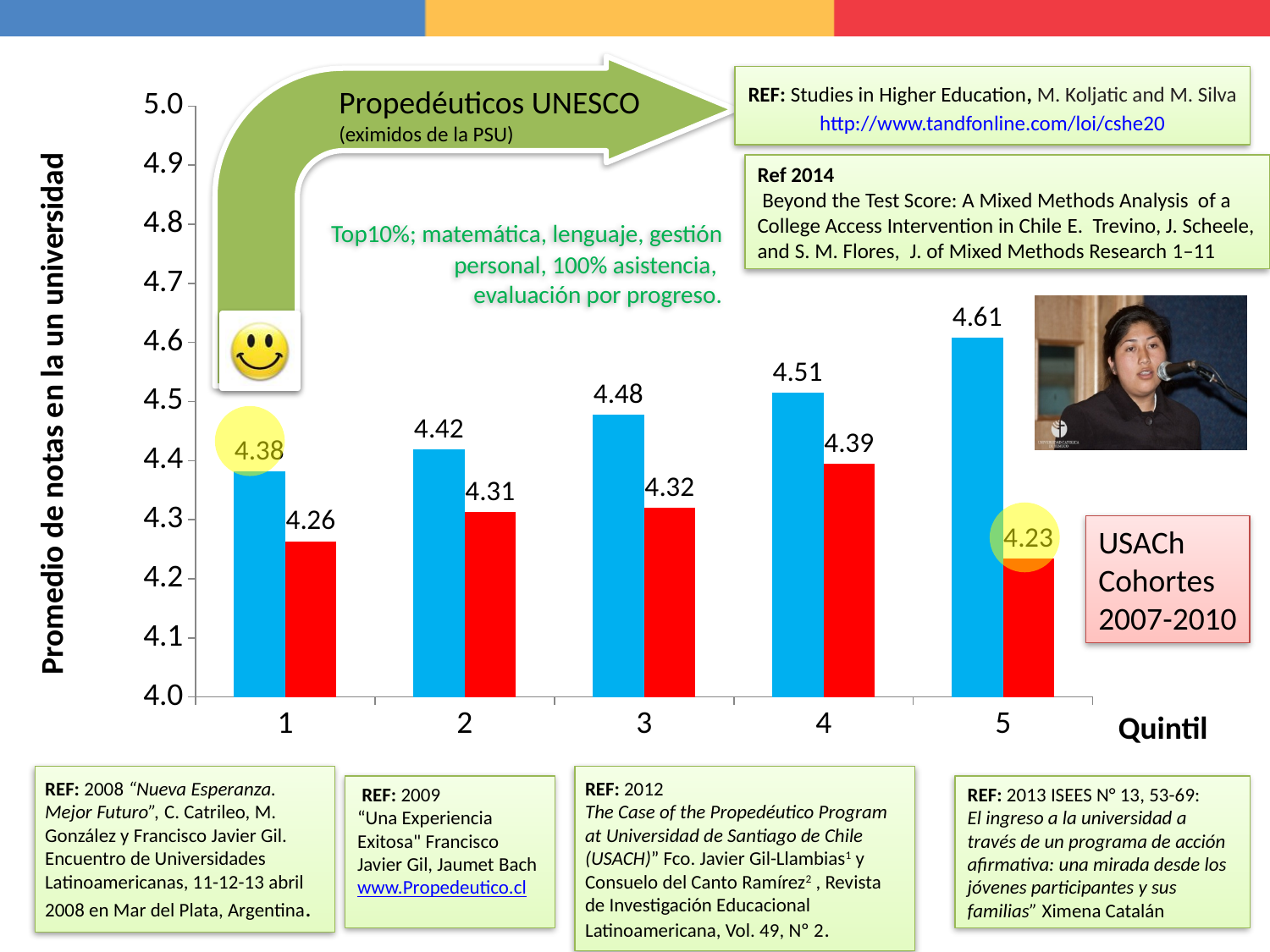
What is the difference between the blue and red bars for quintil 5? 0.38 Which quintil has the lowest red bar? 5 What is the value of the blue bar for quintil 1? 4.38 What is the value of the blue bar for quintil 4? 4.51 Do the blue bar values rise or fall from quintil 1 to quintil 5? rise Which quintil has the highest blue bar? 5 What is the label of the y axis? Promedio de notas en la un universidad How many quintile categories are shown on the x axis? 5 What type of chart is shown on the slide? bar chart What is the value of the red bar for quintil 5? 4.23 What is the value of the red bar for quintil 2? 4.31 Which is larger for quintil 3, the blue bar or the red bar? the blue bar